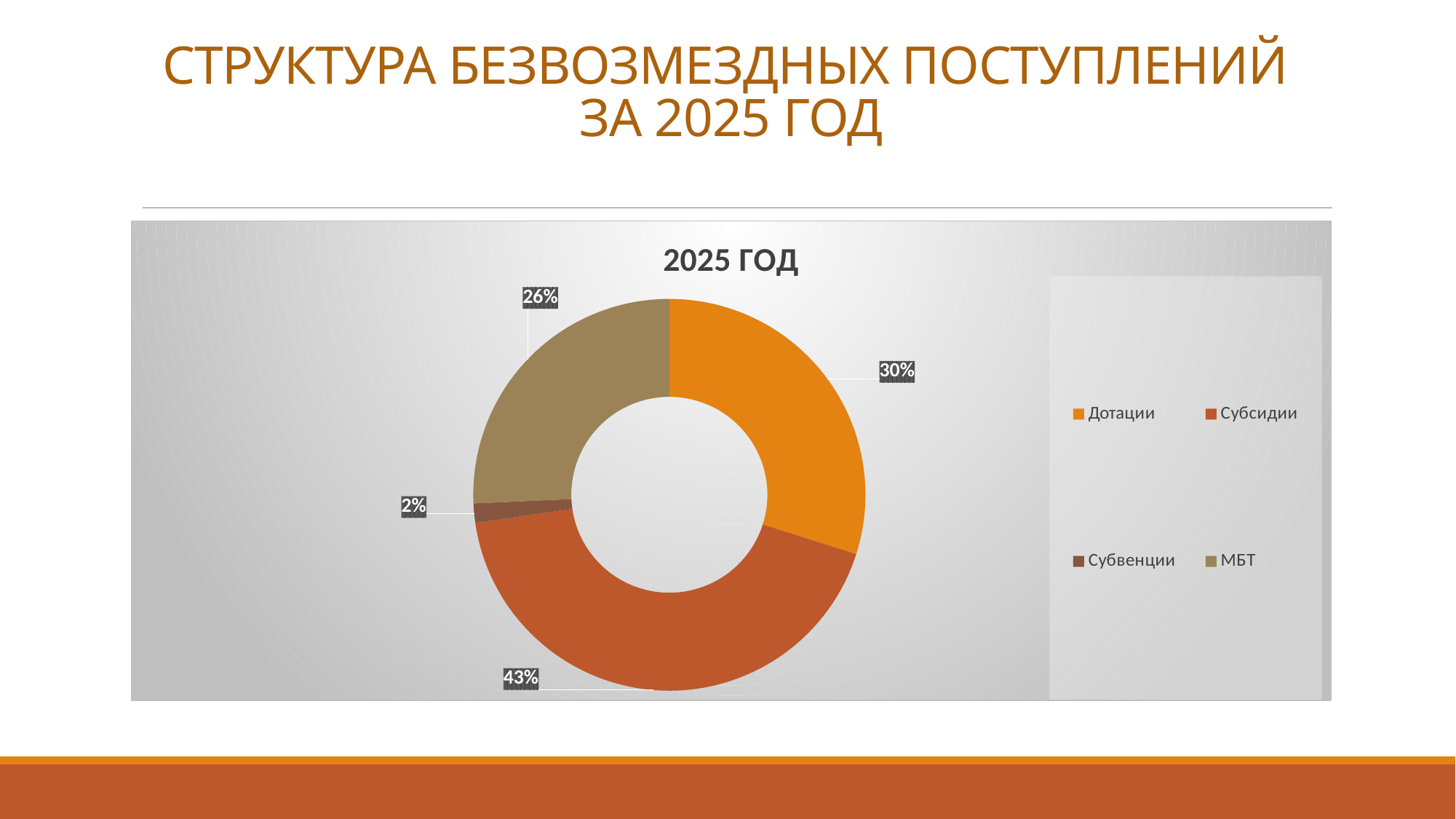
Which category has the largest share? Субсидии What is the value shown for Субвенции? 2% What is the difference between the shares of Субсидии and Дотации? 13% What is the value shown for Дотации? 30% How many categories are shown in the chart? 4 Which category has the smallest share? Субвенции Which is larger, the share of Дотации or the share of МБТ? Дотации What kind of chart is shown on the slide? Pie chart (doughnut) What is the title of the chart? 2025 ГОД What is the difference between the shares of МБТ and Субвенции? 24% What share of the chart does Субсидии account for? 43% What is the value shown for МБТ? 26%